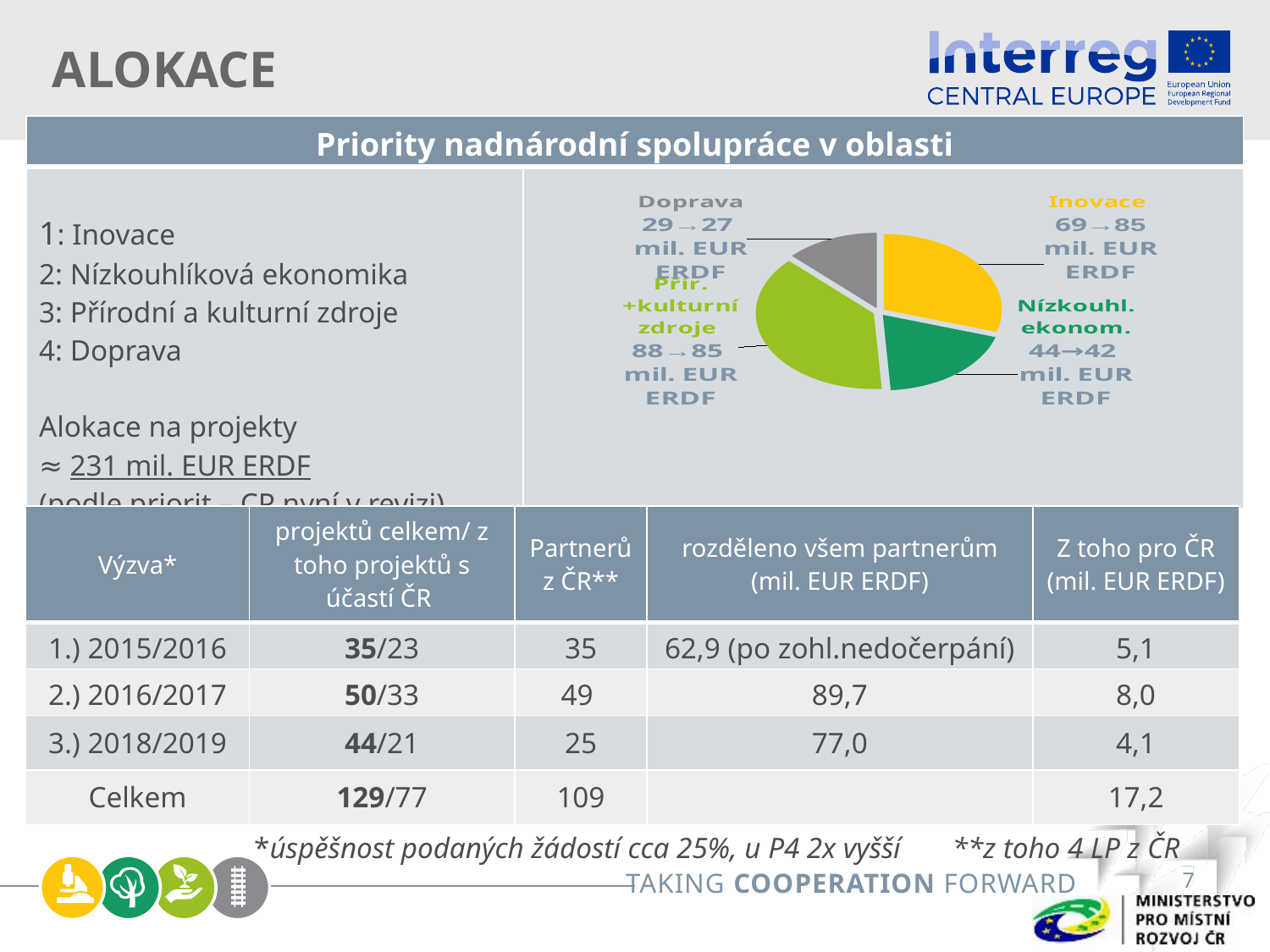
What kind of chart is shown on the slide? pie chart Which slice of the pie chart is the smallest? Doprava What colour is the Doprava slice in the pie chart? grey How many slices does the pie chart have? 4 What is the value after the arrow for Nízkouhl. ekonom. in the pie chart? 42 Which is larger in the pie chart, the Nízkouhl. ekonom. slice or the Doprava slice? Nízkouhl. ekonom. What values are printed for the Inovace slice of the pie chart? 69→85 mil. EUR ERDF What is the value before the arrow for Přír.+kulturní zdroje in the pie chart? 88 What is the difference between the values before the arrow for Inovace (69) and Nízkouhl. ekonom. (44) in the pie chart? 25 What colour is the Inovace slice in the pie chart? yellow What values are printed for the Doprava slice of the pie chart? 29→27 mil. EUR ERDF By how much does the Doprava value change from before the arrow (29) to after the arrow (27)? 2